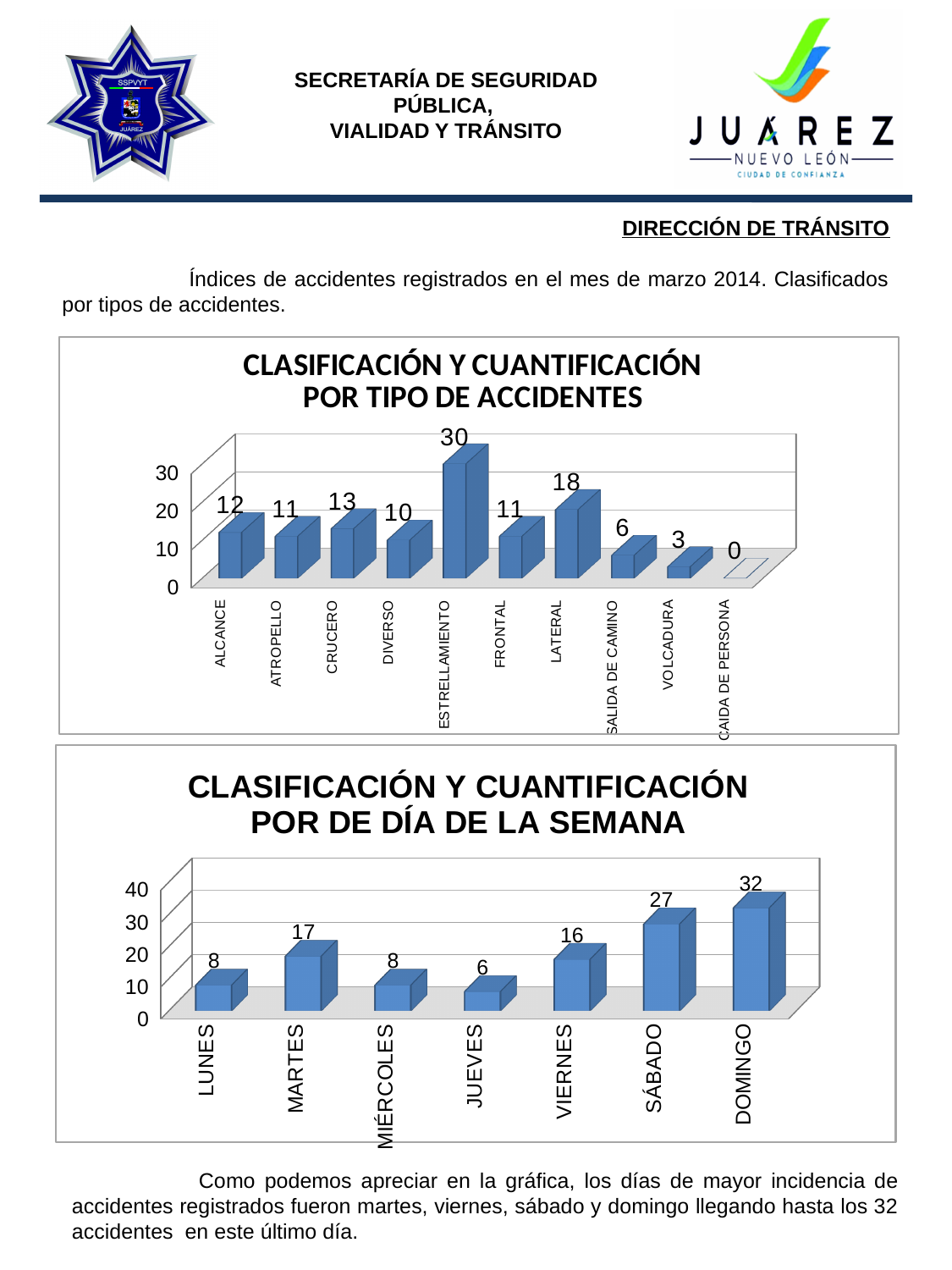
In the chart 'CLASIFICACIÓN Y CUANTIFICACIÓN POR DE DÍA DE LA SEMANA', which is larger, MARTES or VIERNES? MARTES In the chart 'CLASIFICACIÓN Y CUANTIFICACIÓN POR DE DÍA DE LA SEMANA', what is the value for SÁBADO? 27 In the chart 'CLASIFICACIÓN Y CUANTIFICACIÓN POR DE DÍA DE LA SEMANA', which day has the lowest value? JUEVES In the chart 'CLASIFICACIÓN Y CUANTIFICACIÓN POR TIPO DE ACCIDENTES', which accident type has the highest value? ESTRELLAMIENTO What kind of chart is 'CLASIFICACIÓN Y CUANTIFICACIÓN POR DE DÍA DE LA SEMANA'? Bar chart In the chart 'CLASIFICACIÓN Y CUANTIFICACIÓN POR DE DÍA DE LA SEMANA', what is the difference between DOMINGO and LUNES? 24 In the chart 'CLASIFICACIÓN Y CUANTIFICACIÓN POR DE DÍA DE LA SEMANA', which day has the highest value? DOMINGO In the chart 'CLASIFICACIÓN Y CUANTIFICACIÓN POR TIPO DE ACCIDENTES', what is the value for ESTRELLAMIENTO? 30 In the chart 'CLASIFICACIÓN Y CUANTIFICACIÓN POR TIPO DE ACCIDENTES', which accident type has the lowest value? CAIDA DE PERSONA In the chart 'CLASIFICACIÓN Y CUANTIFICACIÓN POR TIPO DE ACCIDENTES', what is the difference between LATERAL and VOLCADURA? 15 In the chart 'CLASIFICACIÓN Y CUANTIFICACIÓN POR TIPO DE ACCIDENTES', what is the value for SALIDA DE CAMINO? 6 In the chart 'CLASIFICACIÓN Y CUANTIFICACIÓN POR TIPO DE ACCIDENTES', how many accident types are shown? 10